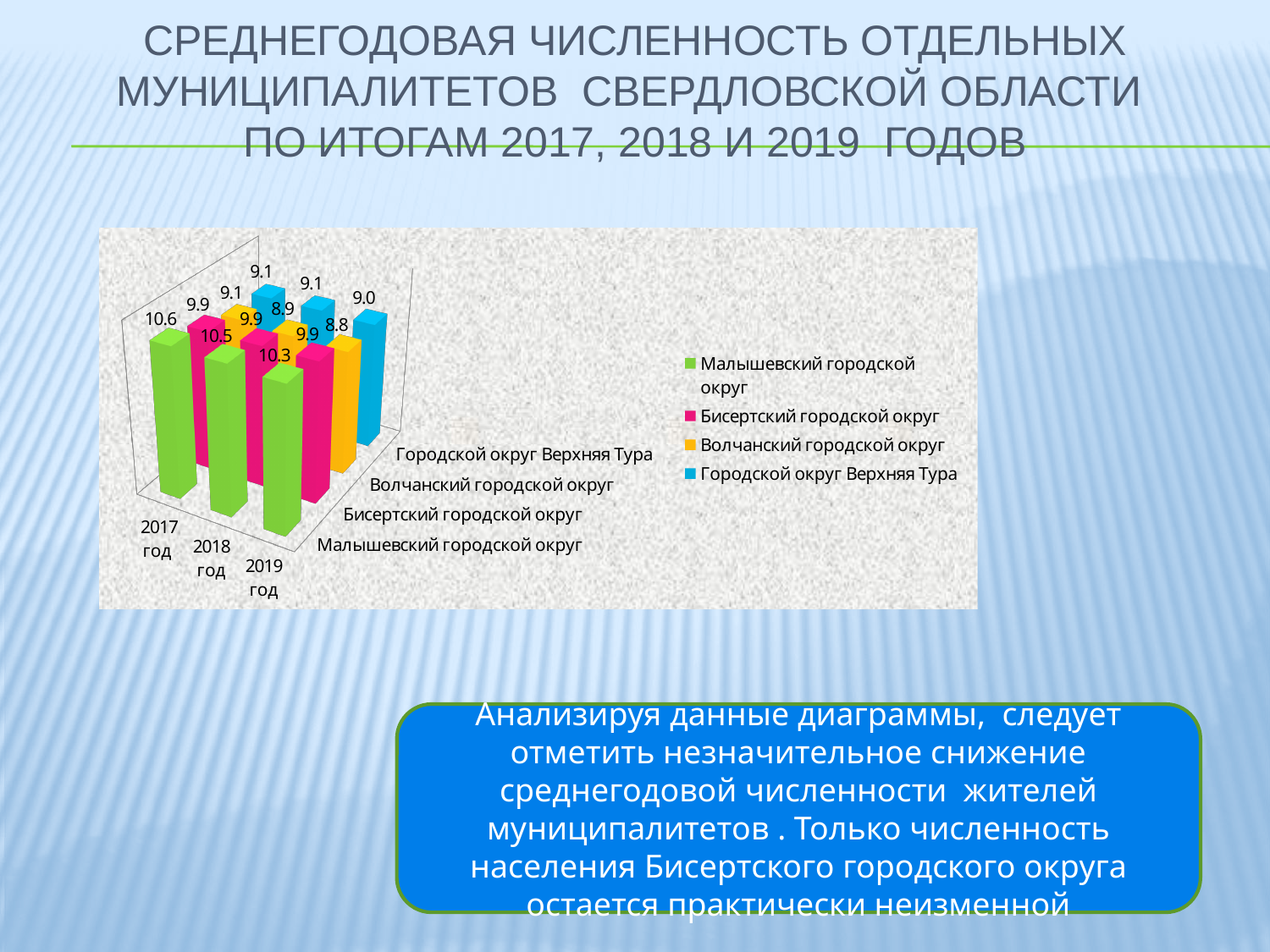
What is the value for Малышевский городской округ in 2019 год? 10.3 Which is larger: the value for Бисертский городской округ in 2019 год or the value for Волчанский городской округ in 2019 год? Бисертский городской округ What is the value for Волчанский городской округ in 2019 год? 8.8 Which municipality has the lowest value in 2019 год? Волчанский городской округ What is the value for Городской округ Верхняя Тура in 2019 год? 9.0 Do the values for Волчанский городской округ rise or fall from 2017 год to 2019 год? Fall How many series does the legend list? 4 Which municipality has the highest value in 2017 год? Малышевский городской округ What kind of chart is shown on the slide? Bar chart What is the value for Бисертский городской округ in 2018 год? 9.9 What is the value for Малышевский городской округ in 2017 год? 10.6 What is the difference between the values for Малышевский городской округ in 2017 год and 2019 год? 0.3